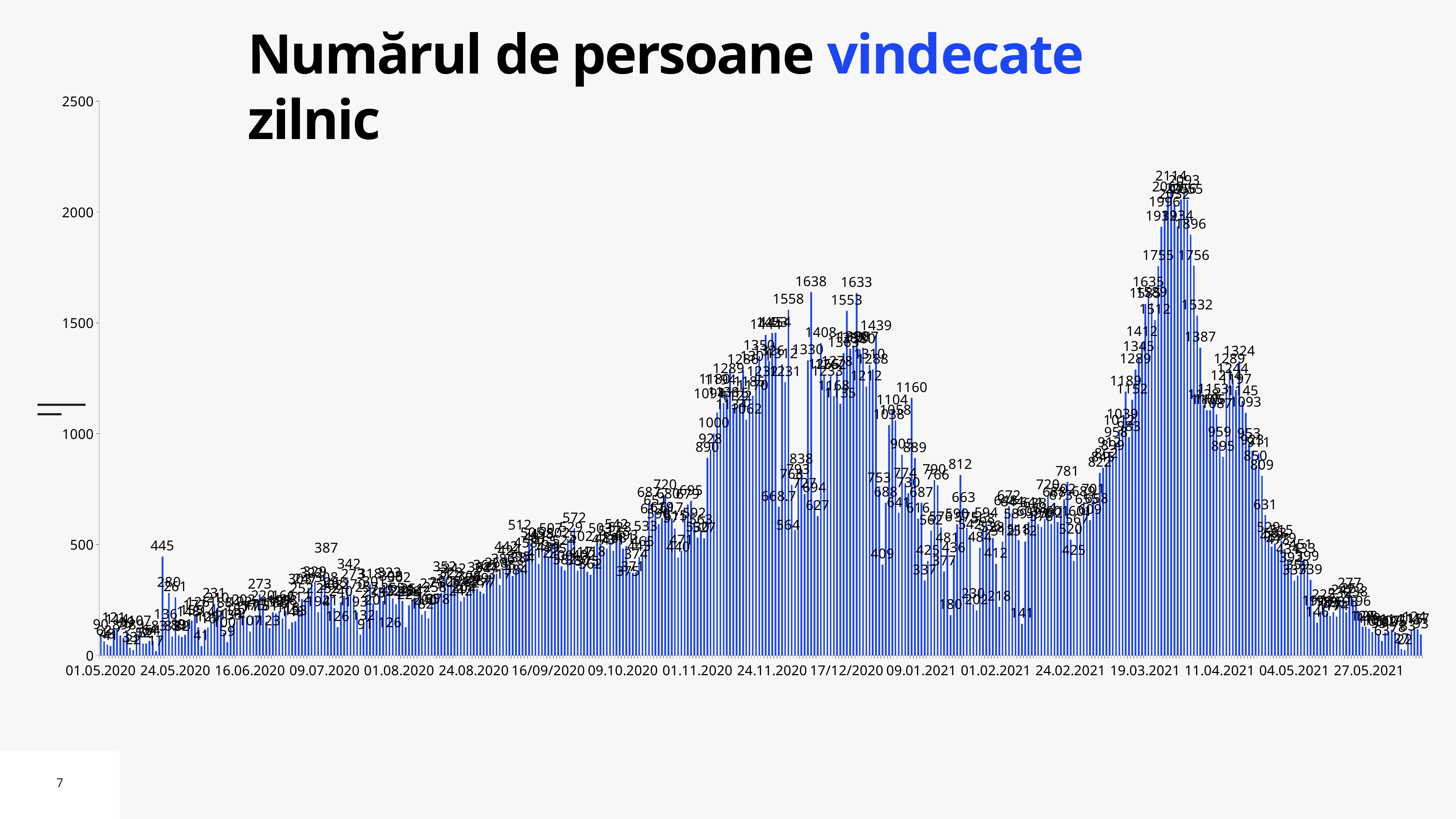
What is the maximum value shown on the vertical axis? 2500 Which peak is higher: the one around 11.04.2021 or the one around 17/12/2020? the one around 11.04.2021 Is the value of the first bar at 01.05.2020 greater or less than 500? less What is the difference between the tallest bar (2114) and the tallest bar of the December 2020 peak (1638)? 476 Do the values rise or fall between 11.04.2021 and 27.05.2021? fall What is the highest value labelled in May 2020 (between 01.05.2020 and 16.06.2020)? 445 What is the highest value labelled in the peak between 24.11.2020 and 17/12/2020? 1638 What is the title of the chart? Numărul de persoane vindecate zilnic What kind of chart is shown on the slide? bar chart What is the value of the tallest bar in the chart? 2114 Do the values rise or fall between 24.02.2021 and 19.03.2021? rise Is the tallest bar in the chart greater or less than 2000? greater